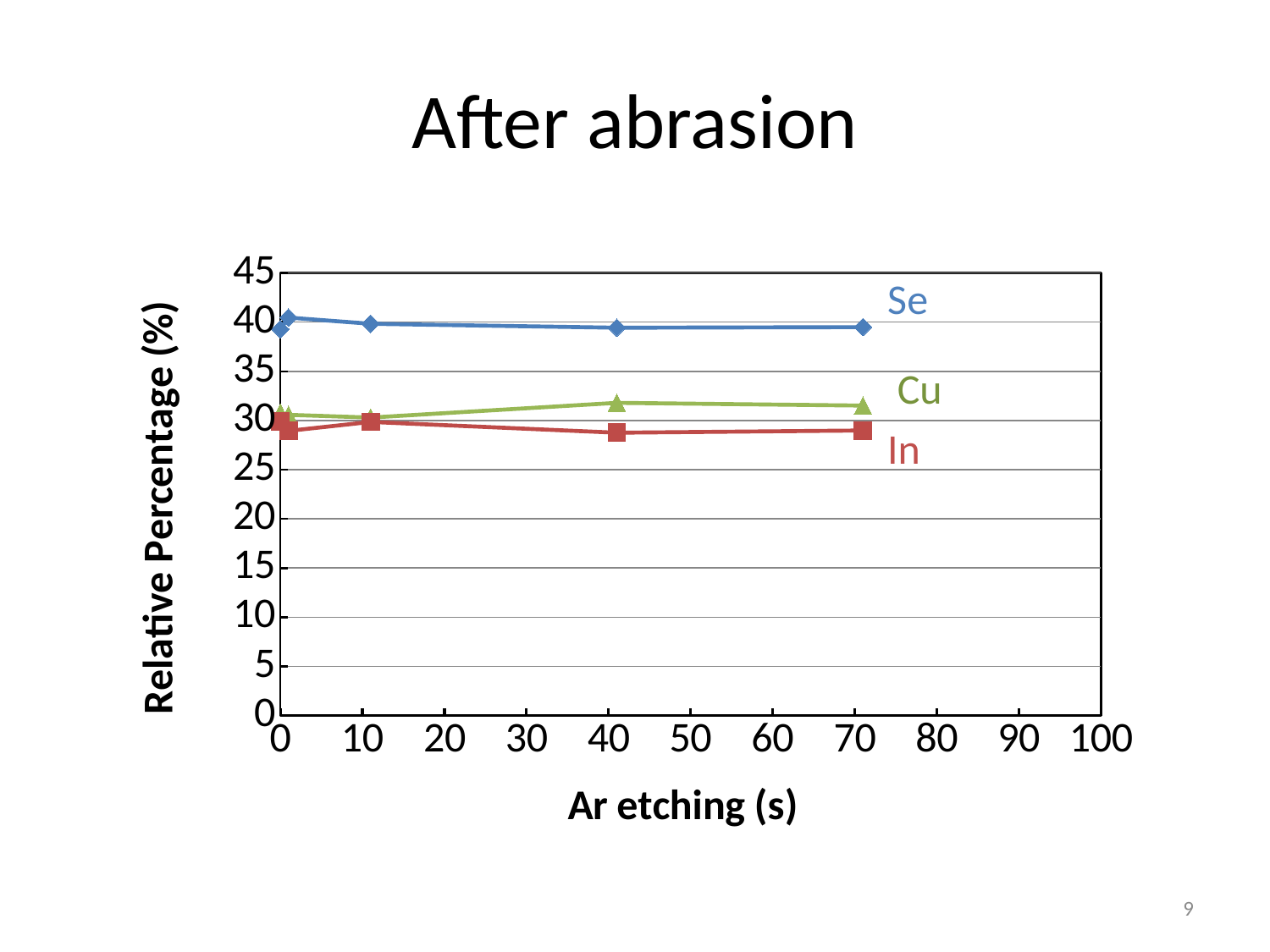
Which series has the highest relative percentage across the chart? Se What kind of chart is shown on the slide? line chart At 41 s of Ar etching, which series has the larger value, Se or In? Se Is the value for In at 41 s greater or less than 25? greater What is the title of the slide? After abrasion How many series are plotted on the chart? 3 At 71 s of Ar etching, which series has the larger value, Cu or In? Cu Is the value for Se at 71 s greater or less than 35? greater Which series has the lowest relative percentage at 71 s of Ar etching? In What is the label of the x axis? Ar etching (s) Is the value for Se at 0 s greater or less than 45? less